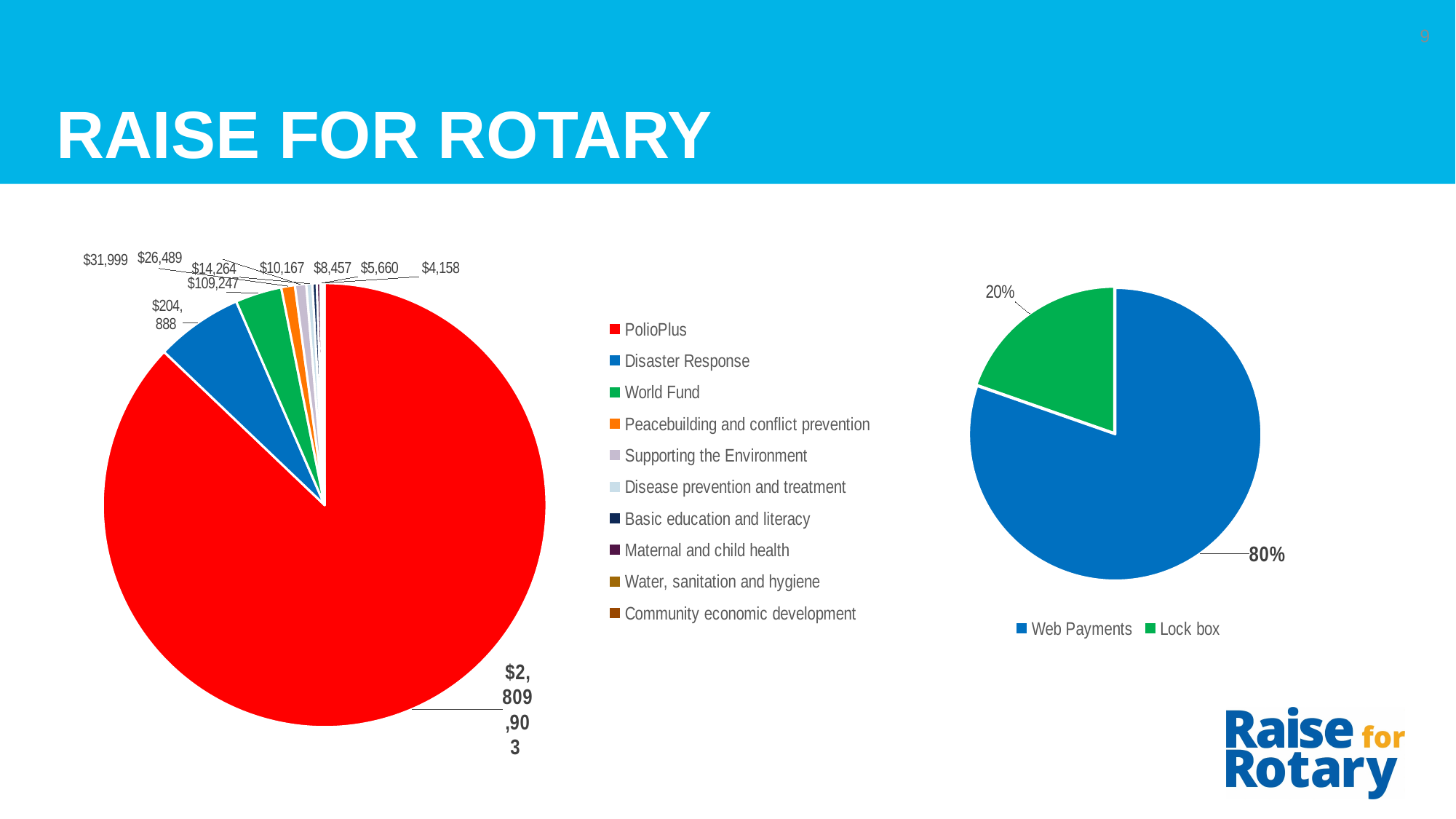
In the right-hand chart, by how many percentage points does Web Payments exceed Lock box? 60 percentage points What kind of chart is the chart on the left of the slide? Pie chart In the right-hand chart, which is larger, Web Payments or Lock box? Web Payments How many entries does the legend of the right-hand chart list? 2 In the pie chart on the right, what share is labelled for Web Payments? 80% In the pie chart on the left, which category has the largest slice? PolioPlus In the pie chart on the right, what share is labelled for Lock box? 20% In the left-hand pie chart, which slice is larger, Disaster Response or World Fund? Disaster Response In the pie chart on the left, what value is labelled for Disaster Response? $204,888 In the pie chart on the left, what value is labelled for PolioPlus? $2,809,903 What kind of chart is the chart on the right of the slide? Pie chart How many categories does the legend of the left-hand pie chart list? 10